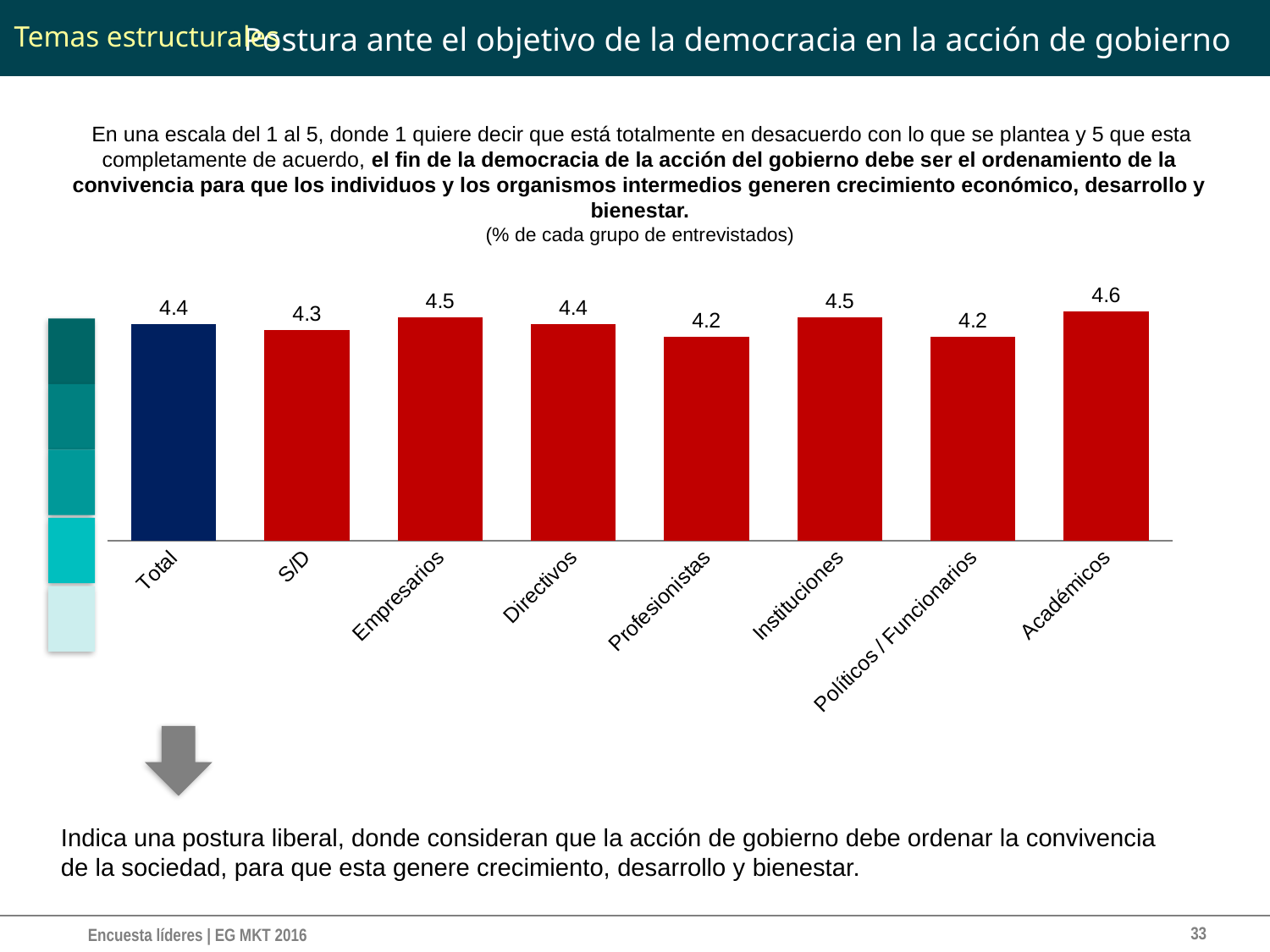
Which category has the highest value? Académicos What is the value for Total? 4.4 What is the value for Políticos / Funcionarios? 4.2 What kind of chart is shown on the slide? Bar chart What is the value for Instituciones? 4.5 What is the value for S/D? 4.3 What is the difference between the values for Académicos and Profesionistas? 0.4 What is the value for Académicos? 4.6 Which has a larger value, Empresarios or Profesionistas? Empresarios Which bar is coloured differently from the others? Total What is the difference between the values for Empresarios and S/D? 0.2 How many categories are shown on the x axis? 8